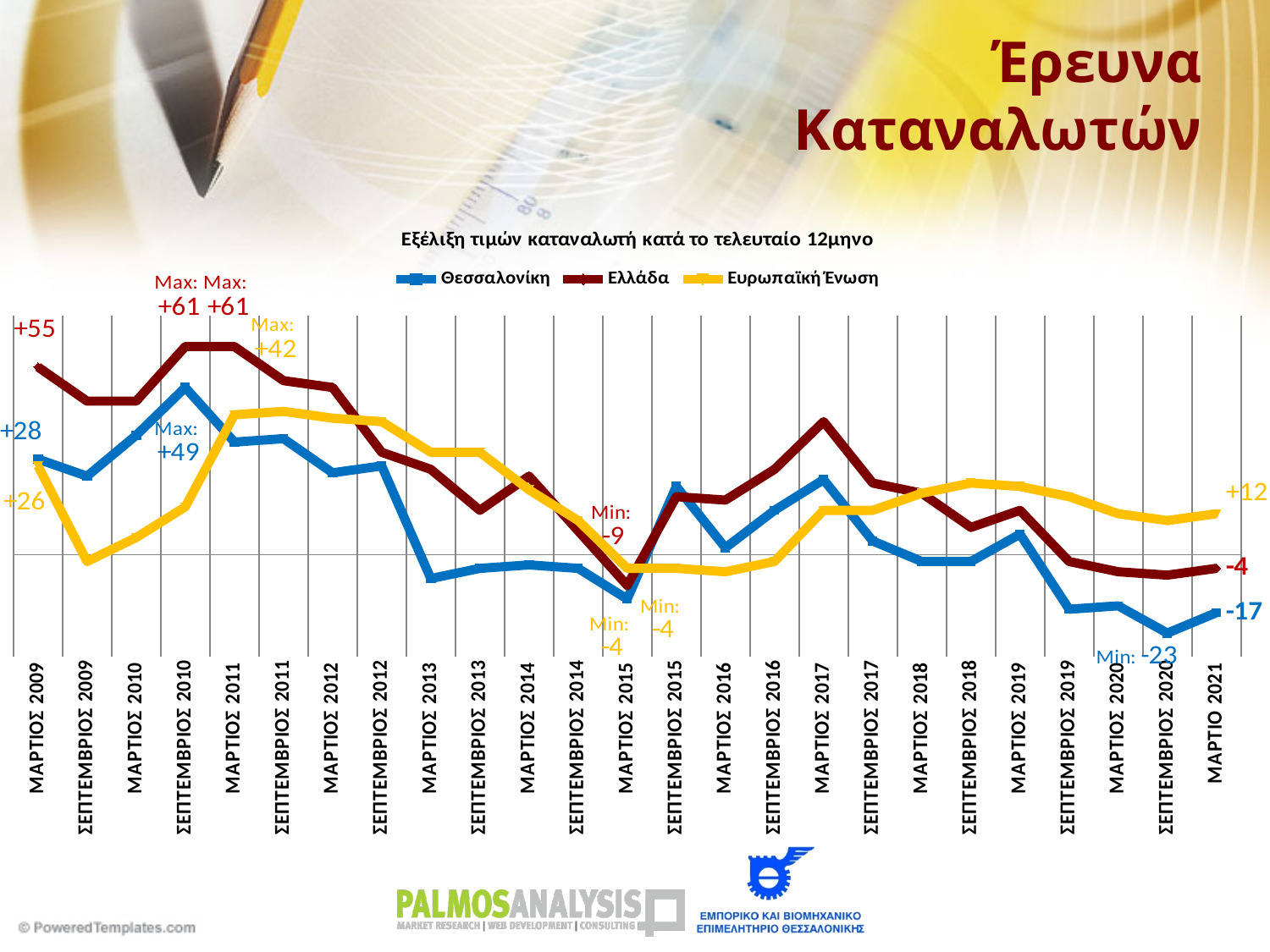
What kind of chart is shown on the slide? Line chart How many time points are shown on the x axis? 25 By how much did the Ελλάδα value fall from ΜΑΡΤΙΟΣ 2009 (+55) to ΜΑΡΤΙΟ 2021 (-4)? 59 What is the minimum value reached by the Ελλάδα series? -9 What is the value for Ελλάδα in ΜΑΡΤΙΟΣ 2009? +55 What is the value for Θεσσαλονίκη in ΜΑΡΤΙΟ 2021? -17 What is the maximum value reached by the Θεσσαλονίκη series? +49 What is the value for Ευρωπαϊκή Ένωση in ΜΑΡΤΙΟ 2021? +12 Which series has the highest value in ΜΑΡΤΙΟ 2021? Ευρωπαϊκή Ένωση How many series does the legend list? 3 What is the maximum value reached by the Ελλάδα series? +61 What is the value for Ελλάδα in ΜΑΡΤΙΟ 2021? -4